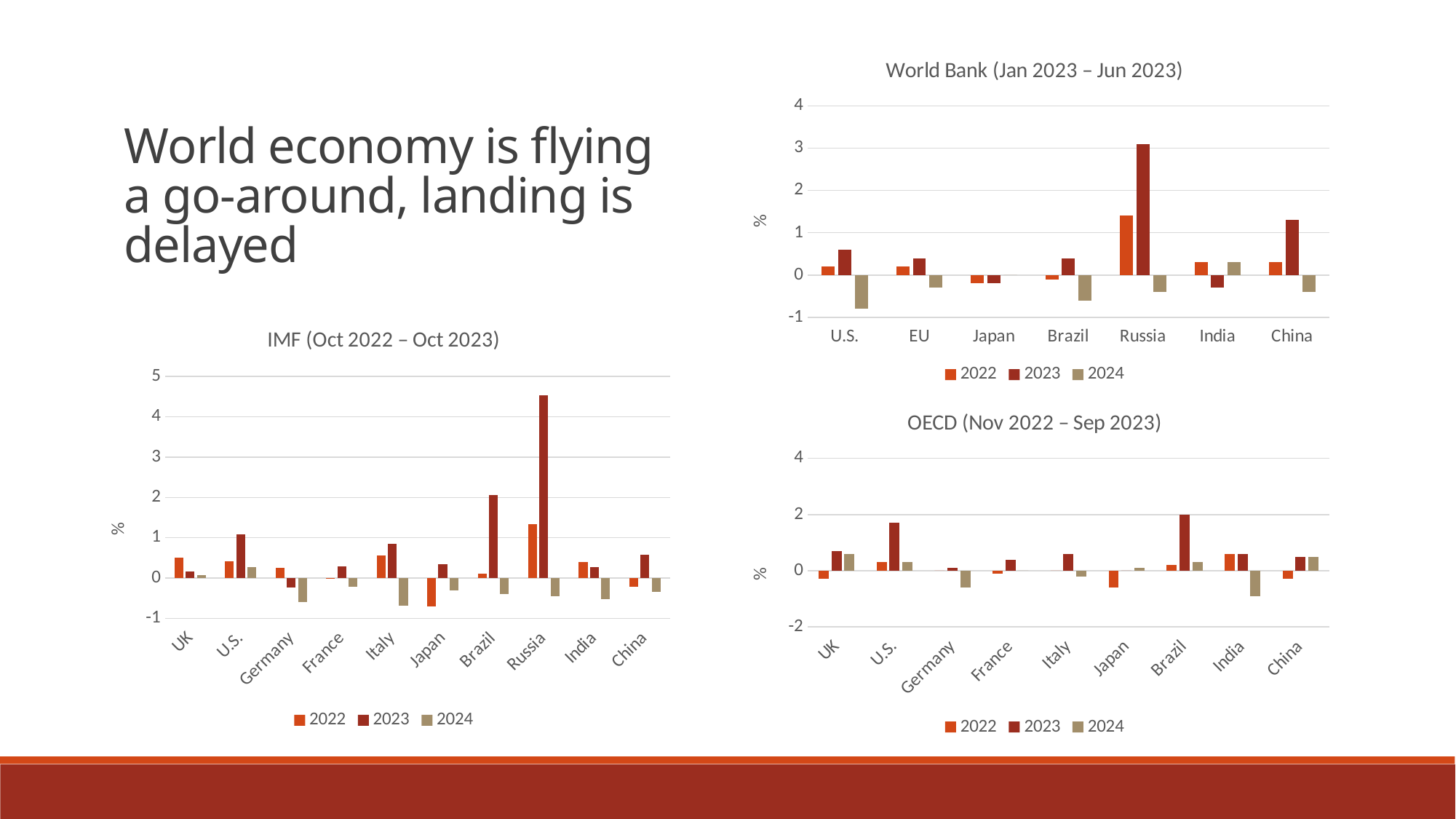
In the IMF (Oct 2022 – Oct 2023) chart, which is larger, the 2023 value for Russia or the 2023 value for Brazil? Russia How many series does the legend of the World Bank (Jan 2023 – Jun 2023) chart list? 3 In the World Bank (Jan 2023 – Jun 2023) chart, which country has the lowest 2024 value? U.S. In the IMF (Oct 2022 – Oct 2023) chart, is the 2023 value for Russia greater or less than 4? greater In the IMF (Oct 2022 – Oct 2023) chart, which country has the lowest 2022 value? Japan In the OECD (Nov 2022 – Sep 2023) chart, which country has the highest 2023 value? Brazil How many countries are shown on the x axis of the IMF (Oct 2022 – Oct 2023) chart? 10 In the World Bank (Jan 2023 – Jun 2023) chart, is the 2023 value for Russia greater or less than 2? greater In the OECD (Nov 2022 – Sep 2023) chart, is the 2024 value for India greater or less than 0? less What kind of chart is the IMF (Oct 2022 – Oct 2023) chart? bar chart How many countries are shown on the x axis of the World Bank (Jan 2023 – Jun 2023) chart? 7 In the IMF (Oct 2022 – Oct 2023) chart, which country has the highest 2023 value? Russia